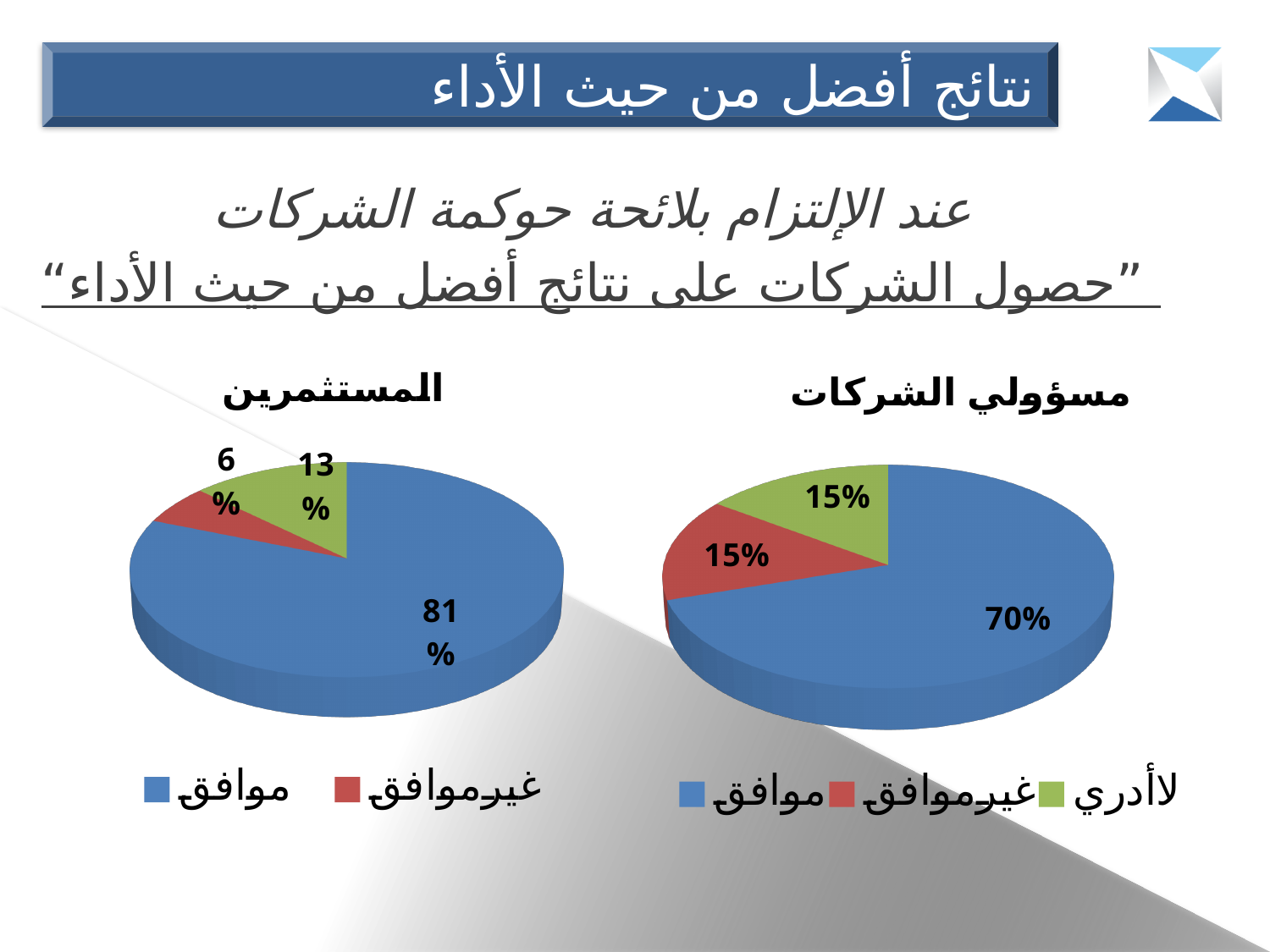
In the "المستثمرين" pie chart, what percentage is shown for "غيرموافق"? 6% In the "مسؤولي الشركات" pie chart, what percentage is shown for "غيرموافق"? 15% In the "مسؤولي الشركات" pie chart, which category has the largest slice? موافق Which chart shows a larger share for "موافق", "المستثمرين" or "مسؤولي الشركات"? المستثمرين In the "مسؤولي الشركات" pie chart, what percentage is shown for "موافق"? 70% In the "المستثمرين" pie chart, which category has the smallest slice? غيرموافق In the "المستثمرين" pie chart, which category has the largest slice? موافق In the "مسؤولي الشركات" pie chart, what percentage is shown for "لاأدري"? 15% How many slices does the "مسؤولي الشركات" pie chart have? 3 What is the difference between the "موافق" share in the "المستثمرين" chart and the "موافق" share in the "مسؤولي الشركات" chart? 11% In the "المستثمرين" pie chart, what percentage is shown for "موافق"? 81% What type of chart is used for "مسؤولي الشركات"? Pie chart